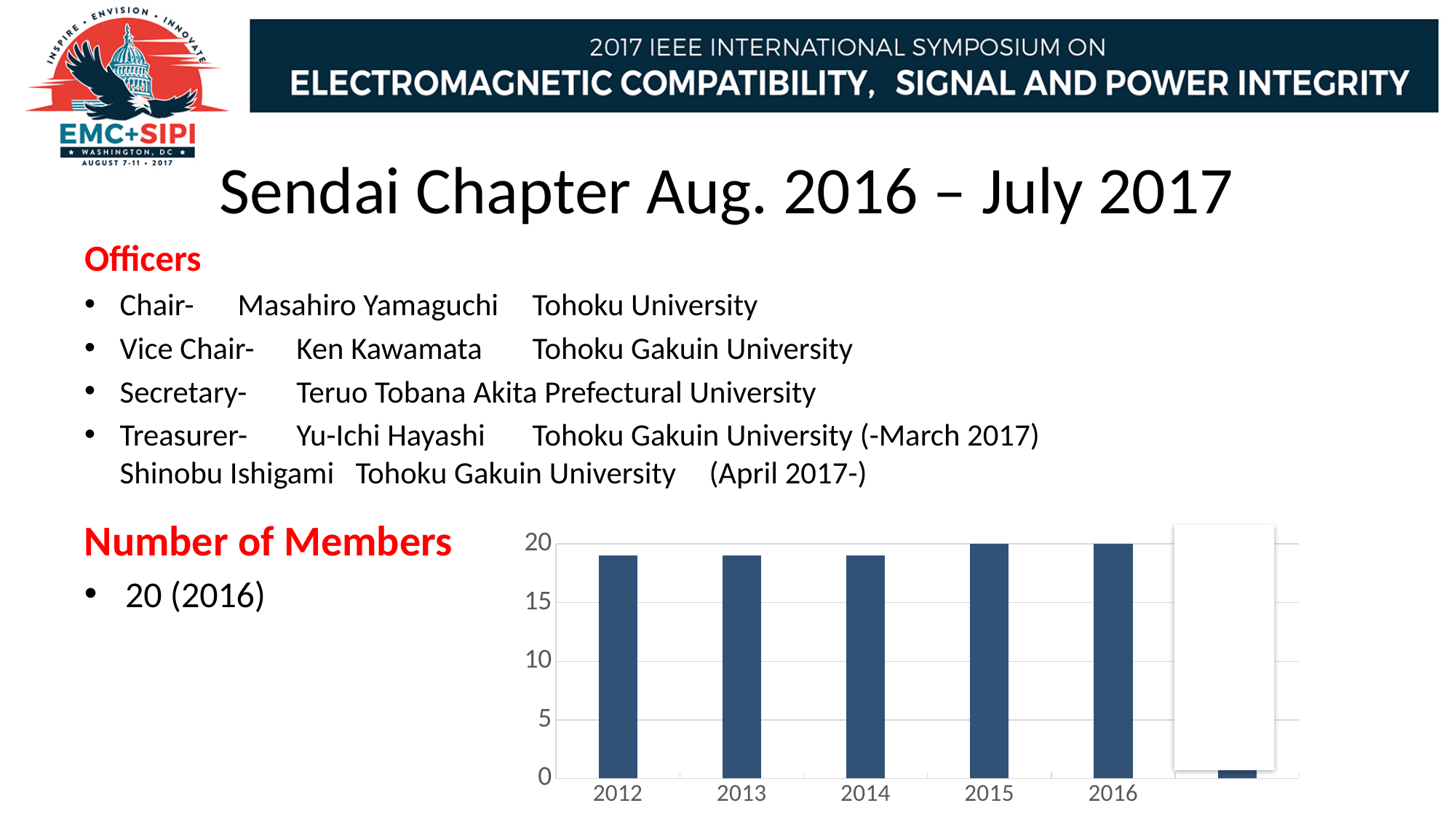
What is the highest value labeled on the y axis? 20 Which year has the larger value, 2012 or 2016? 2016 What kind of chart is shown on the slide? bar chart What is the first year labeled on the x axis? 2012 Do the values rise or fall from 2012 to 2016? rise Is the value for 2013 greater or less than 10? greater Is the value for 2014 greater or less than 20? less Is the value for 2012 greater or less than 15? greater What is the number of members shown for 2015? 20 How many years are labeled on the x axis of the chart? 5 What is the number of members shown for 2016? 20